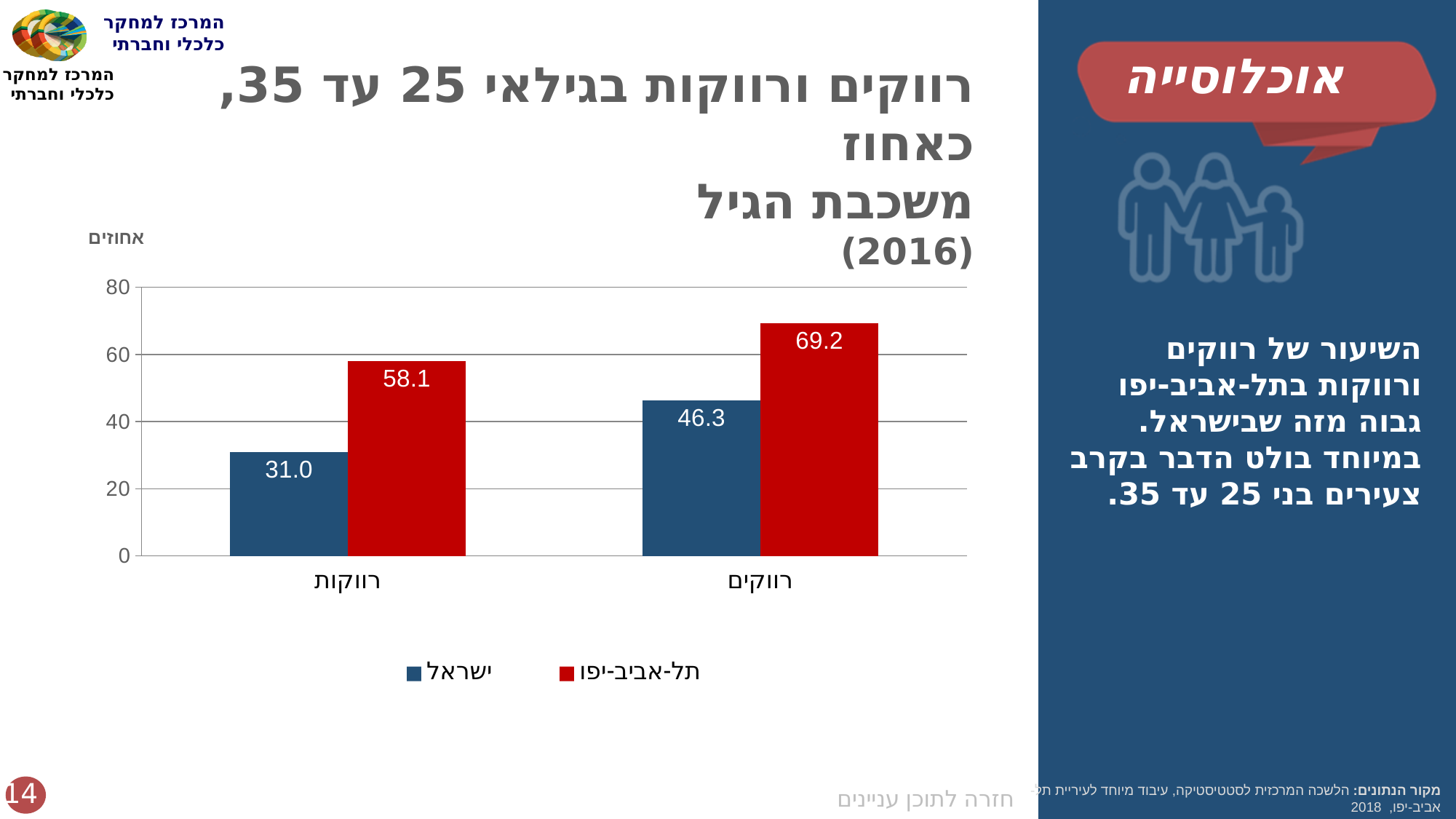
Which is larger: the ישראל value for רווקים or the תל-אביב-יפו value for רווקות? תל-אביב-יפו value for רווקות What is the value for תל-אביב-יפו in the רווקים category? 69.2 What is the difference between the תל-אביב-יפו and ישראל values in the רווקות category? 27.1 Which bar has the lowest value on the chart? ישראל, רווקות What is the value for תל-אביב-יפו in the רווקות category? 58.1 Which bar has the highest value on the chart? תל-אביב-יפו, רווקים What is the value for ישראל in the רווקים category? 46.3 Which colour represents תל-אביב-יפו in the chart? Red What is the difference between the תל-אביב-יפו and ישראל values in the רווקים category? 22.9 How many series does the legend list? 2 What kind of chart is shown on the slide? Bar chart What is the value for ישראל in the רווקות category? 31.0